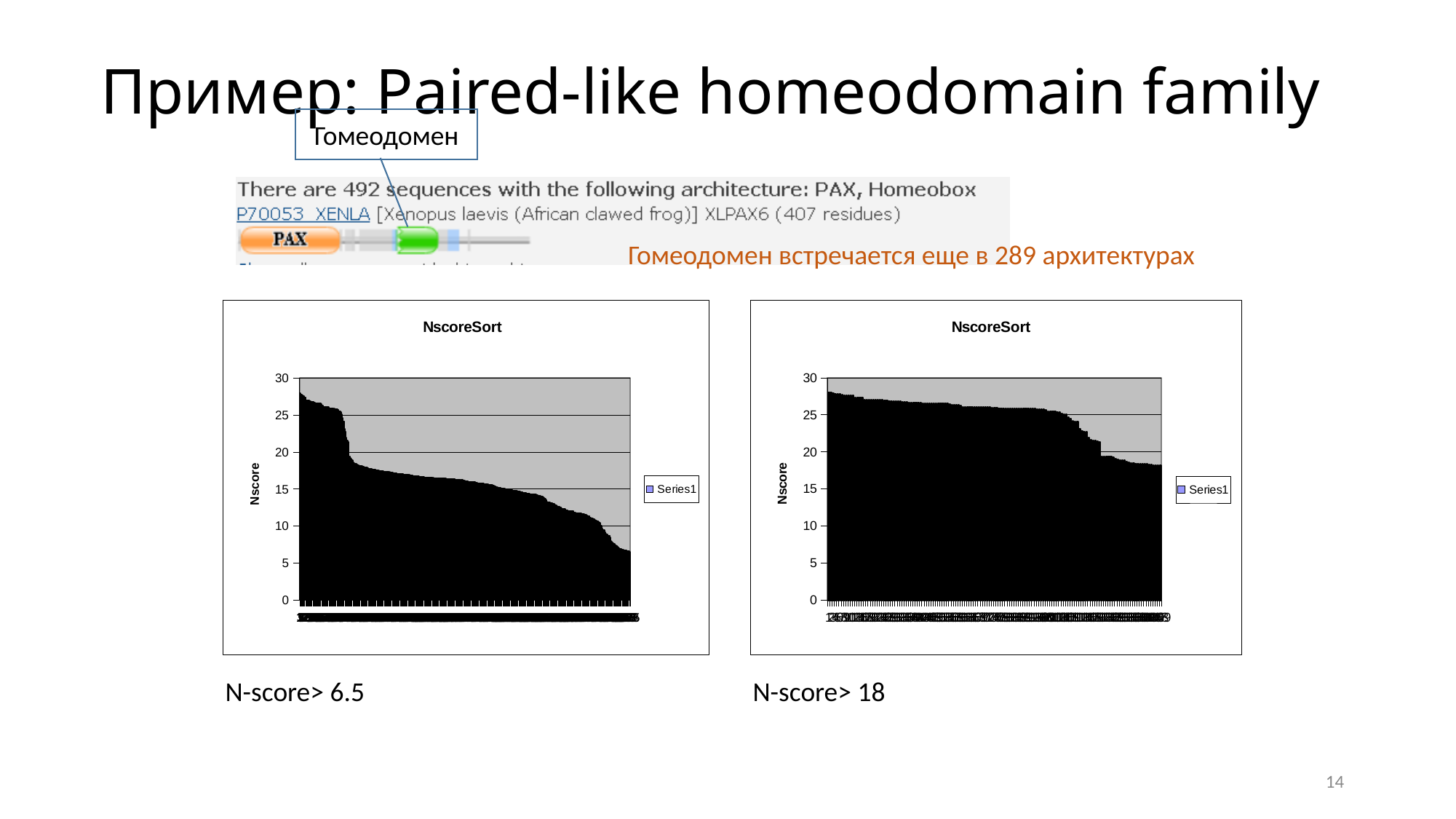
What kind of chart is the right chart on the slide? bar chart In the left chart, is the value of the first (leftmost) bar greater or less than 25? greater What is the title of the left chart? NscoreSort In the left chart, do the values rise or fall along the x axis? fall In the left chart, is the value of the last (rightmost) bar greater or less than 10? less In the right chart, is the value of the last (rightmost) bar greater or less than 15? greater How many series does the legend of the left chart list? 1 How many series does the legend of the right chart list? 1 In the right chart, do the values rise or fall along the x axis? fall What kind of chart is the left chart on the slide? bar chart What is the y-axis label of the right chart? Nscore